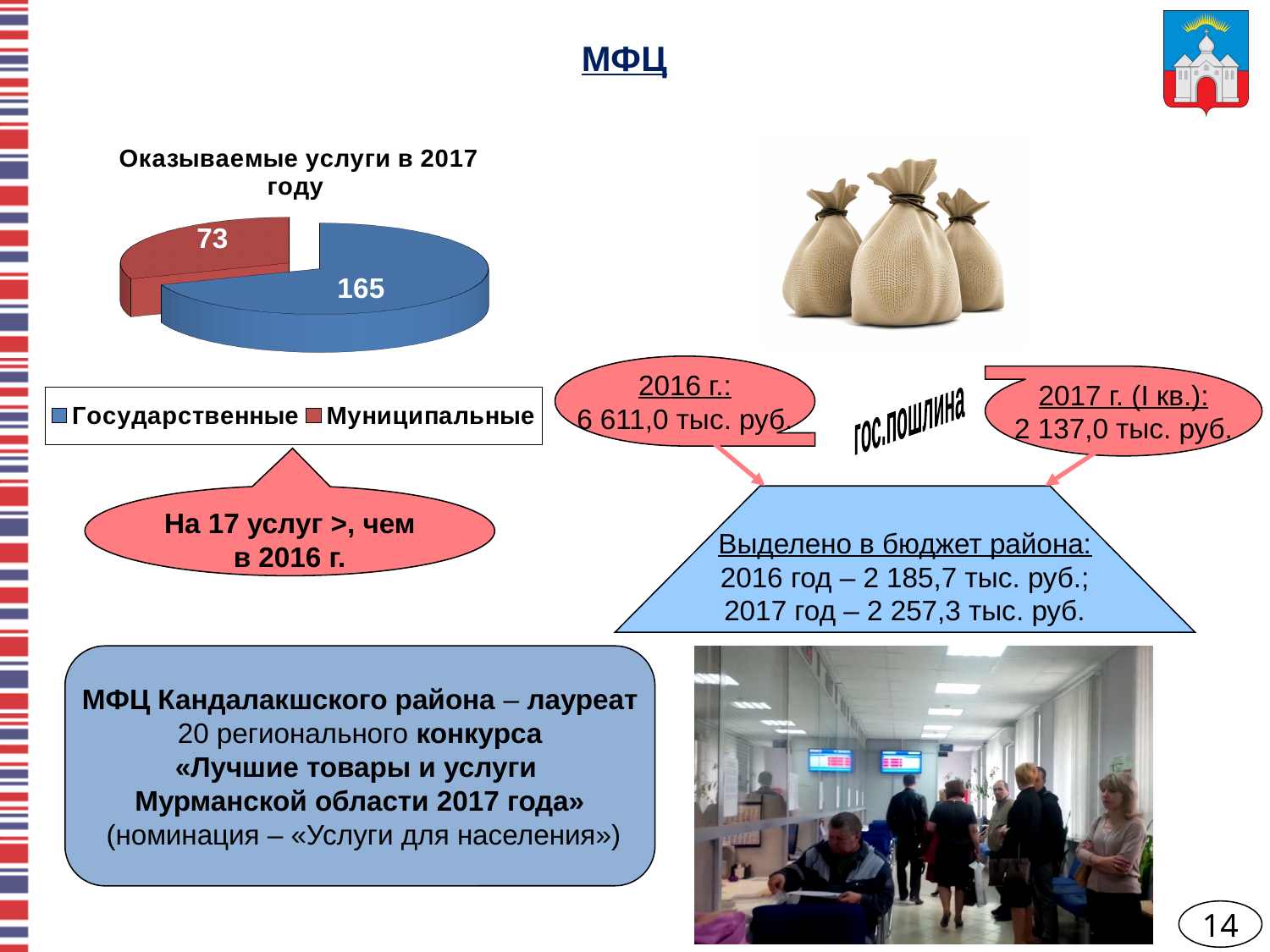
What colour is the Государственные slice in the pie chart? Blue What is the title of the pie chart on the slide? Оказываемые услуги в 2017 году In the pie chart "Оказываемые услуги в 2017 году", which is larger: Государственные or Муниципальные? Государственные In the pie chart "Оказываемые услуги в 2017 году", what is the difference between the Государственные and Муниципальные values? 92 In the pie chart "Оказываемые услуги в 2017 году", what is the value for Муниципальные? 73 How many slices does the pie chart "Оказываемые услуги в 2017 году" have? 2 Which category has the smallest slice in the pie chart "Оказываемые услуги в 2017 году"? Муниципальные What kind of chart is shown under the title "Оказываемые услуги в 2017 году"? Pie chart In the pie chart "Оказываемые услуги в 2017 году", what is the value for Государственные? 165 What is the total of the two values shown in the pie chart "Оказываемые услуги в 2017 году"? 238 How many entries does the legend of the pie chart "Оказываемые услуги в 2017 году" list? 2 Which category has the largest slice in the pie chart "Оказываемые услуги в 2017 году"? Государственные